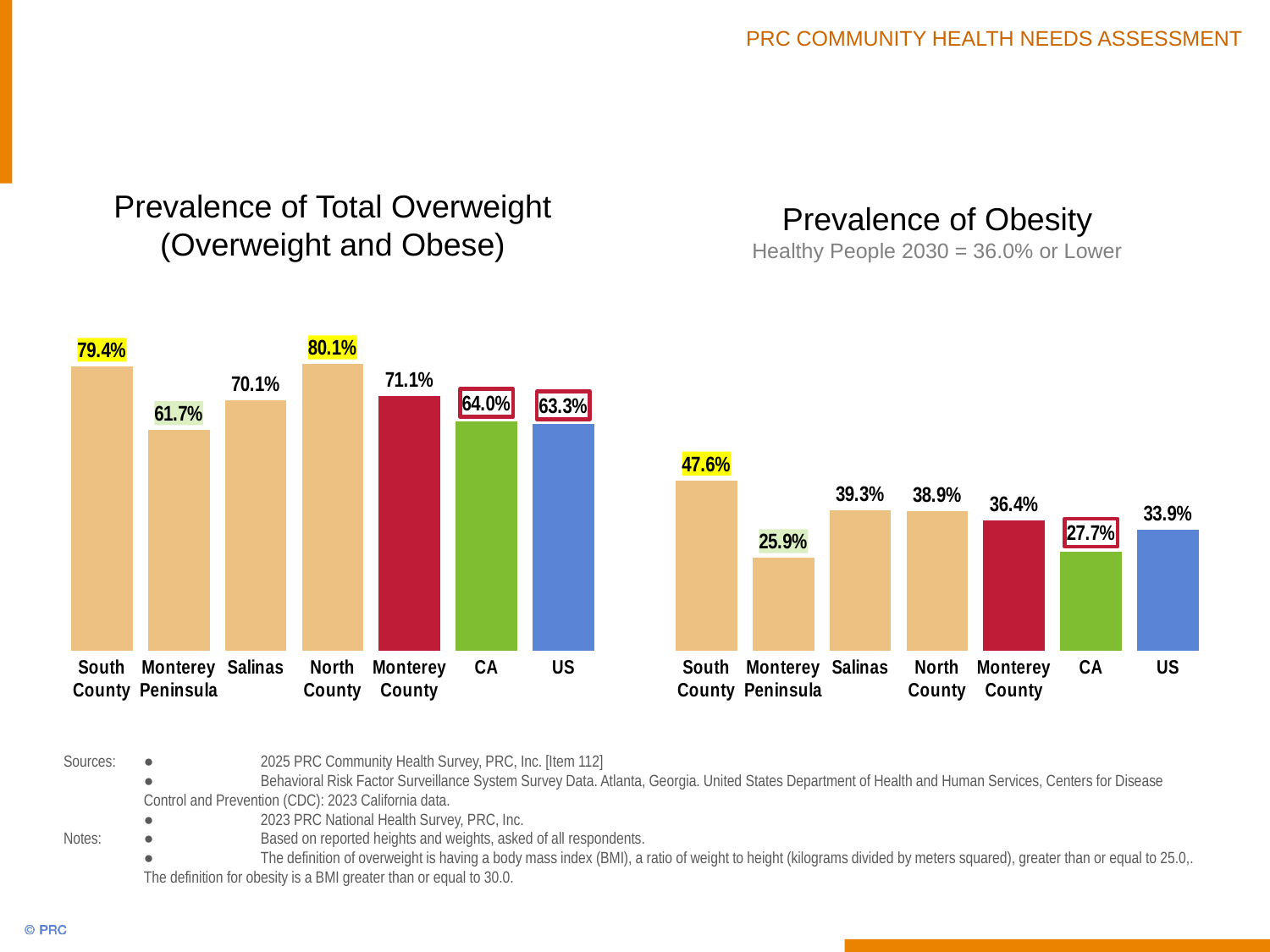
In the 'Prevalence of Obesity' chart, what is the value for US? 33.9% What kind of chart is the 'Prevalence of Total Overweight (Overweight and Obese)' chart? Bar chart In the 'Prevalence of Obesity' chart, what is the difference between the values for South County and CA? 19.9% In the 'Prevalence of Total Overweight (Overweight and Obese)' chart, what is the value for North County? 80.1% In the 'Prevalence of Total Overweight (Overweight and Obese)' chart, which is larger, the value for Salinas or the value for Monterey County? Monterey County In the 'Prevalence of Total Overweight (Overweight and Obese)' chart, what is the difference between the values for CA and US? 0.7% How many categories are shown in the 'Prevalence of Obesity' chart? 7 In the 'Prevalence of Total Overweight (Overweight and Obese)' chart, which category has the lowest value? Monterey Peninsula What Healthy People 2030 target is shown under the 'Prevalence of Obesity' chart title? 36.0% or Lower In the 'Prevalence of Obesity' chart, which category has the highest value? South County In the 'Prevalence of Obesity' chart, which is larger, the value for Salinas or the value for North County? Salinas In the 'Prevalence of Obesity' chart, what is the value for Monterey Peninsula? 25.9%